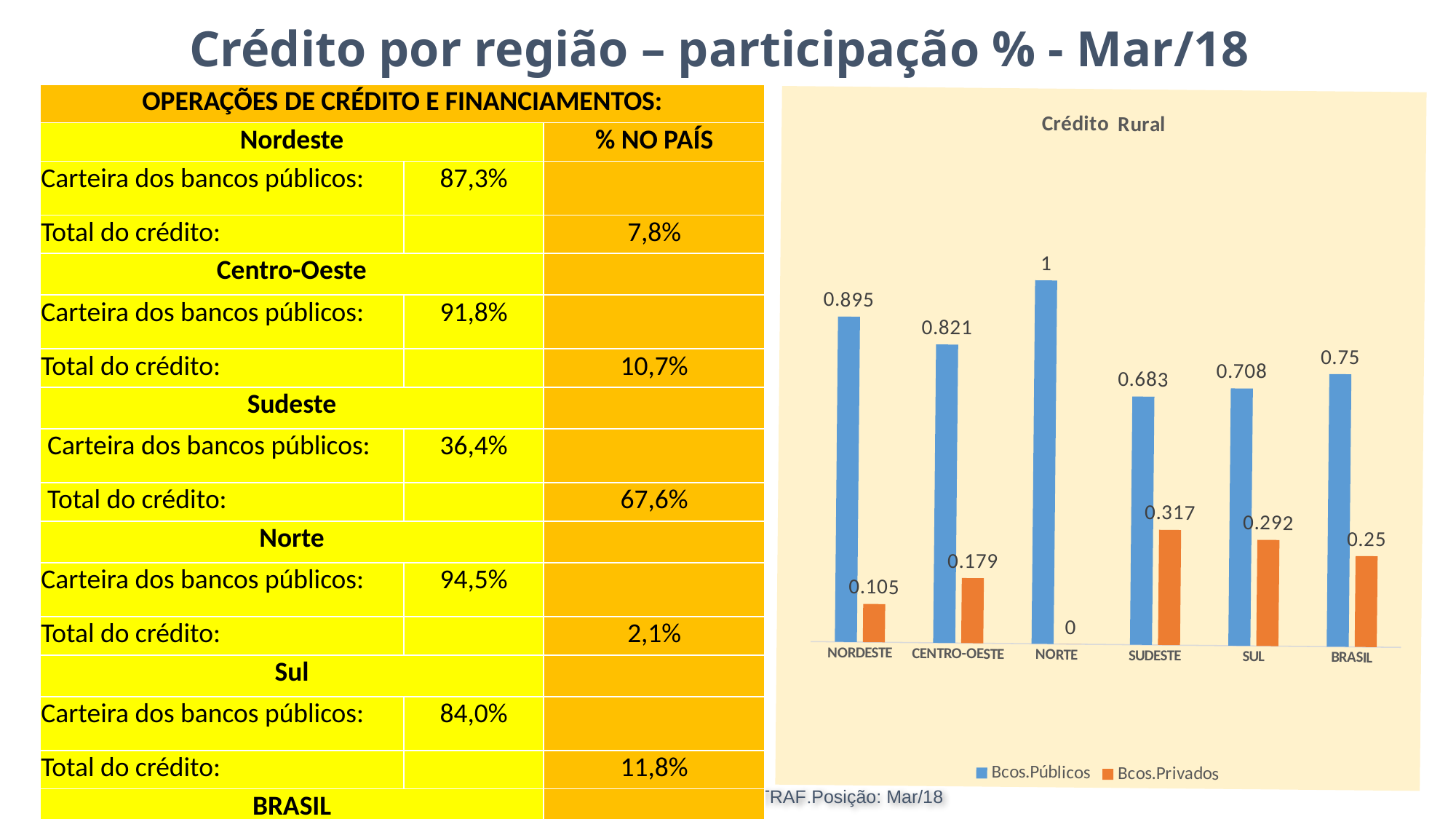
How many series does the legend of the Crédito Rural chart list? 2 What kind of chart is the Crédito Rural chart? Bar chart In the Crédito Rural chart, what is the value for Bcos.Privados in BRASIL? 0.25 In the Crédito Rural chart, what is the value for Bcos.Públicos in NORDESTE? 0.895 In the Crédito Rural chart, which colour represents Bcos.Privados? Orange In the Crédito Rural chart, what is the value for Bcos.Privados in SUDESTE? 0.317 In the Crédito Rural chart, what is the difference between the Bcos.Públicos values for CENTRO-OESTE and SUL? 0.113 In the Crédito Rural chart, which category has the lowest Bcos.Privados value? NORTE In the Crédito Rural chart, which category has the highest Bcos.Públicos value? NORTE How many categories are shown on the x axis of the Crédito Rural chart? 6 In the Crédito Rural chart, which is larger: Bcos.Privados in SUL or Bcos.Privados in CENTRO-OESTE? SUL In the Crédito Rural chart, which category has the lowest Bcos.Públicos value? SUDESTE